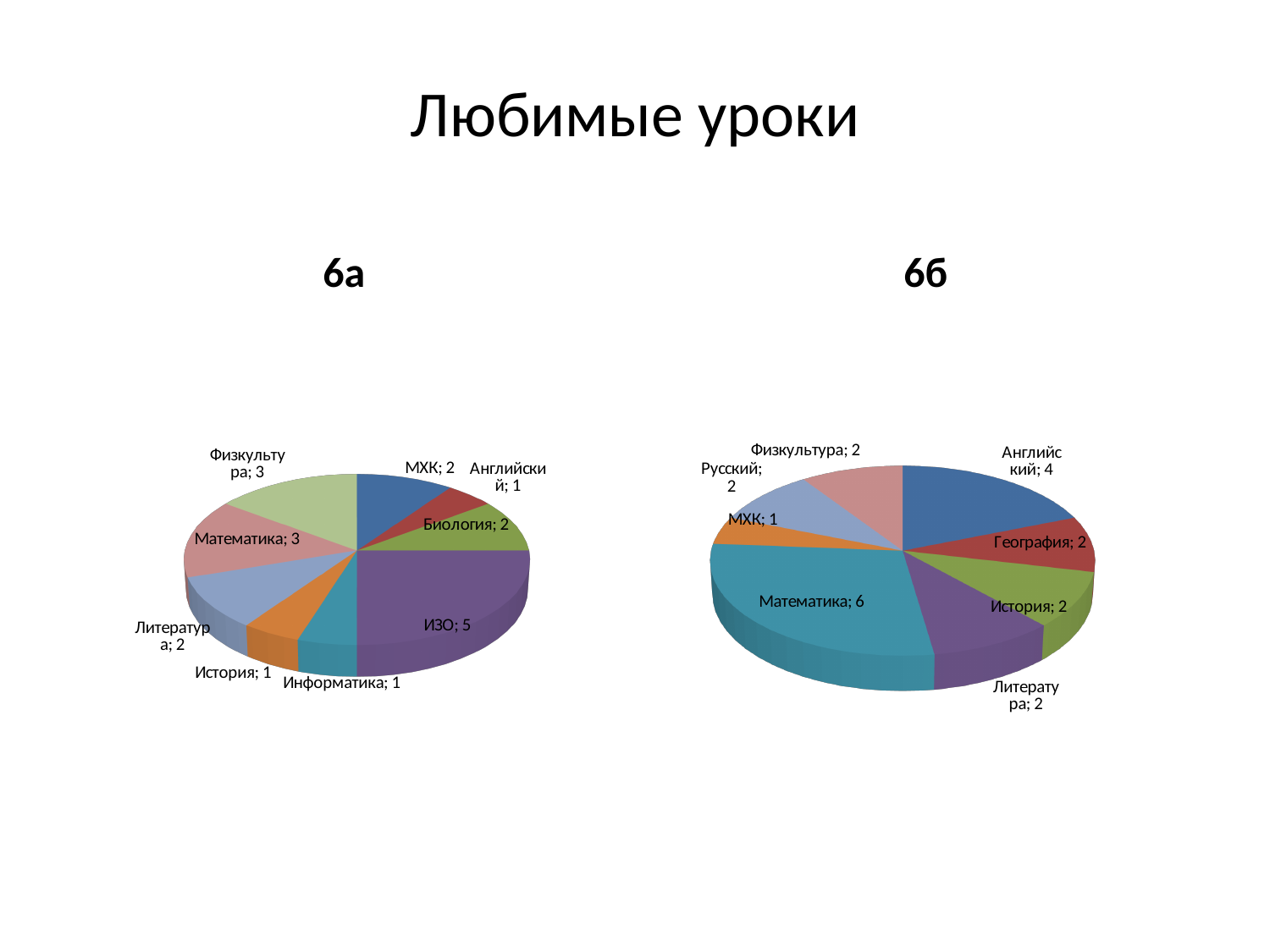
What type of chart is the 6а chart? Pie chart What is the title of the slide containing the two charts? Любимые уроки In the 6а chart, what is the difference between the values for ИЗО and Математика? 2 How many slices does the 6а chart have? 9 How many slices does the 6б chart have? 8 In the 6а chart, which subject has the largest slice? ИЗО In the 6б chart, what is the value for Английский? 4 In the 6а chart, what share of the total does ИЗО represent? 25% In the 6а chart, what is the value for ИЗО? 5 In the 6б chart, which is larger, Математика or Английский? Математика In the 6б chart, which subject has the largest slice? Математика In the 6б chart, which subject has the smallest slice? МХК